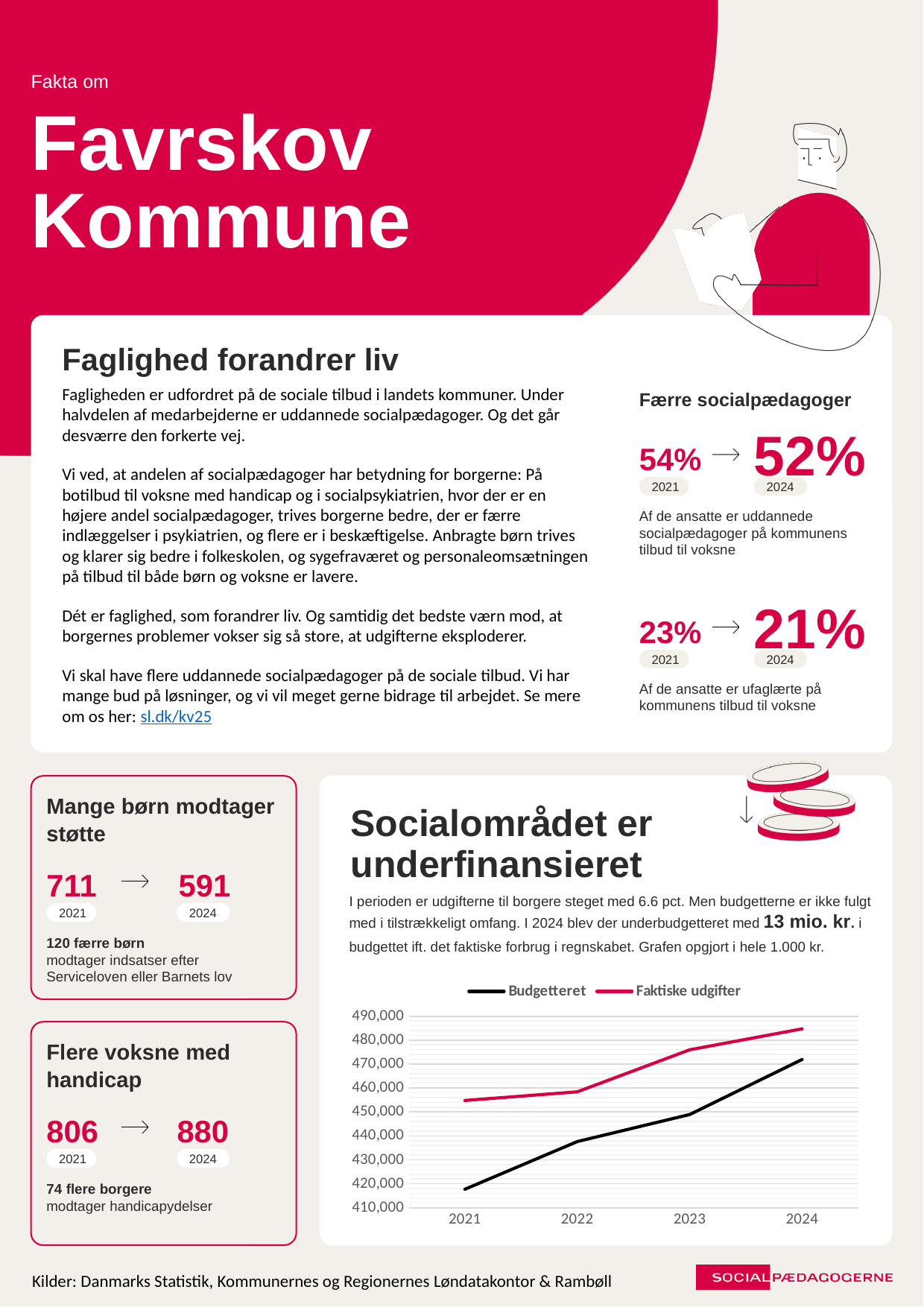
What kind of chart is shown under the heading 'Socialområdet er underfinansieret'? line chart Is the Faktiske udgifter value for 2024 greater or less than 480,000? greater Which two series are listed in the legend of the line chart? Budgetteret and Faktiske udgifter Is the Budgetteret value for 2023 greater or less than 460,000? less In which year is the Budgetteret line at its lowest? 2021 How many years are plotted along the x axis of the line chart? 4 Does the Budgetteret line rise or fall from 2021 to 2024? rise Does the Faktiske udgifter line rise or fall from 2021 to 2024? rise Is the Budgetteret value for 2021 greater or less than 430,000? less In 2024, which series is higher on the line chart, Budgetteret or Faktiske udgifter? Faktiske udgifter In which year is the Faktiske udgifter line at its highest? 2024 How many series does the legend of the line chart list? 2